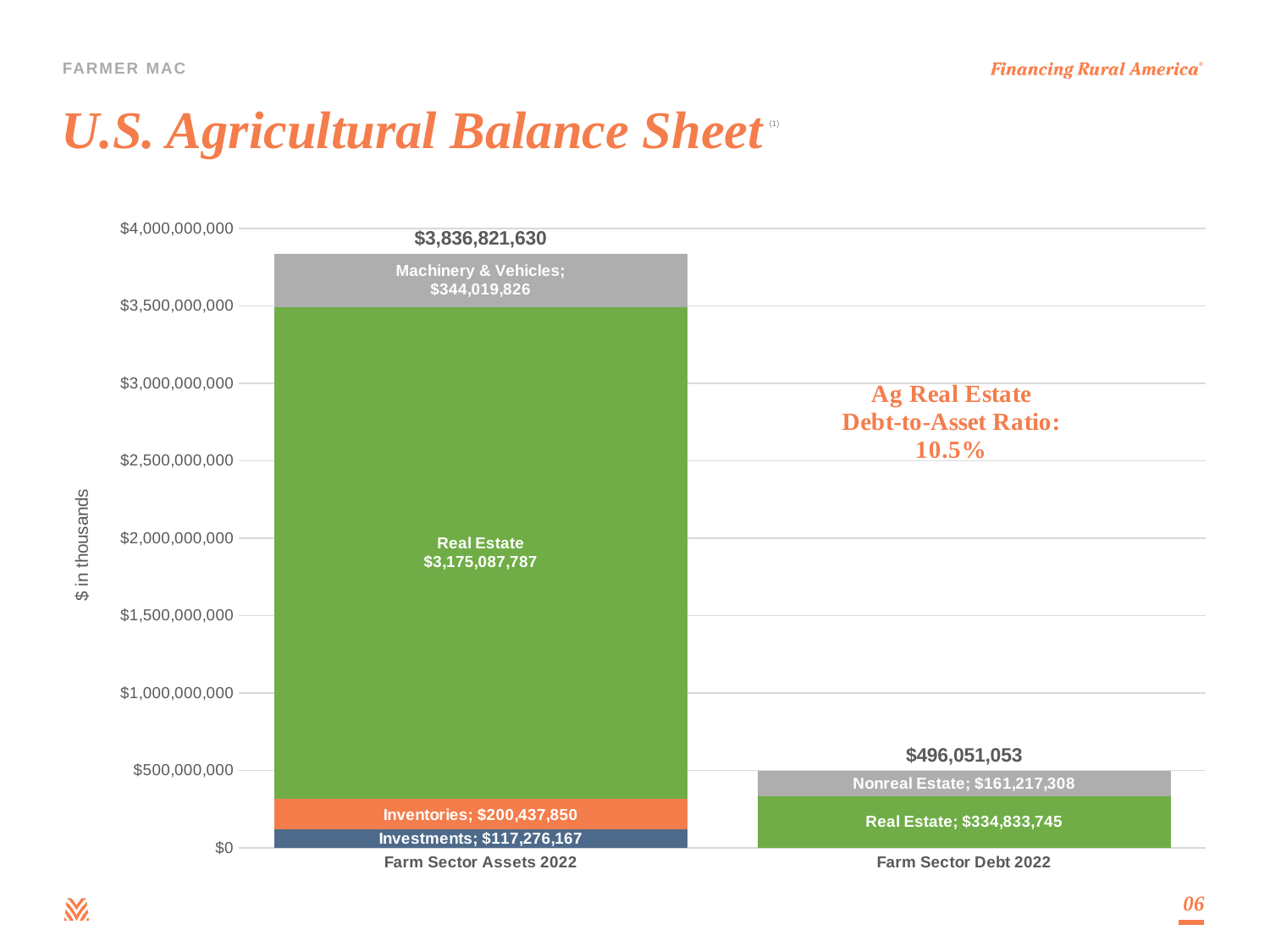
What is the Investments value within Farm Sector Assets 2022? $117,276,167 What is the difference between the Real Estate and Nonreal Estate segments of Farm Sector Debt 2022? $173,616,437 Which segment of the Farm Sector Assets 2022 bar is the largest? Real Estate What is the total value of the Farm Sector Assets 2022 bar? $3,836,821,630 What is the Ag Real Estate Debt-to-Asset Ratio shown on the chart? 10.5% What is the Nonreal Estate value within Farm Sector Debt 2022? $161,217,308 Which is larger: Machinery & Vehicles in Farm Sector Assets 2022 or Real Estate in Farm Sector Debt 2022? Machinery & Vehicles in Farm Sector Assets 2022 What is the total value of the Farm Sector Debt 2022 bar? $496,051,053 How many bars (categories) are shown on the x axis? 2 Which segment of the Farm Sector Assets 2022 bar is the smallest? Investments What is the Real Estate value within Farm Sector Assets 2022? $3,175,087,787 What is the Machinery & Vehicles value within Farm Sector Assets 2022? $344,019,826